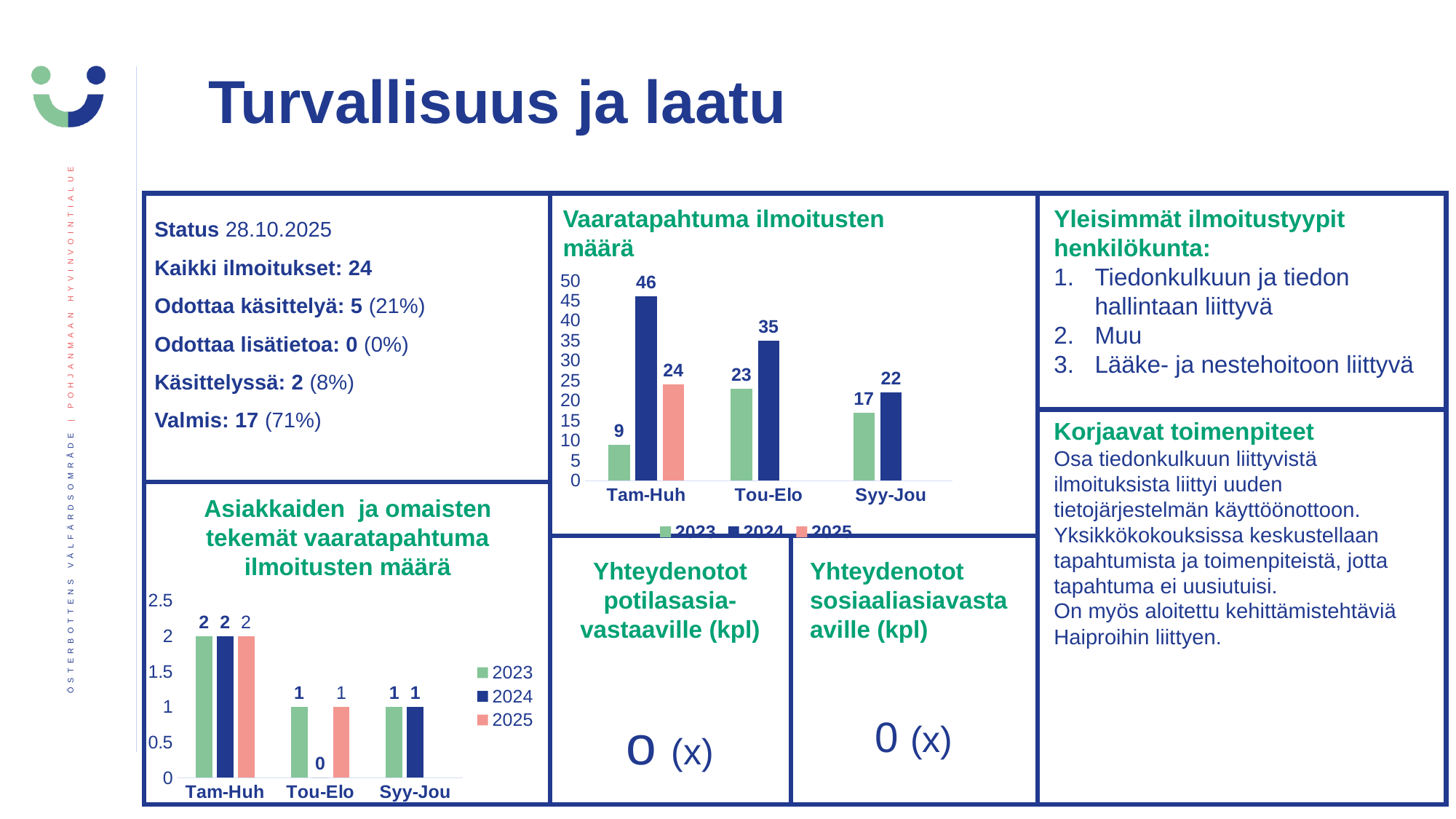
In the 'Vaaratapahtuma ilmoitusten määrä' chart, what is the value for 2024 in Tam-Huh? 46 In the 'Vaaratapahtuma ilmoitusten määrä' chart, which period has the lowest 2023 value? Tam-Huh In the 'Asiakkaiden ja omaisten tekemät vaaratapahtuma ilmoitusten määrä' chart, what is the value for 2025 in Tam-Huh? 2 How many periods are shown on the x axis of the 'Asiakkaiden ja omaisten tekemät vaaratapahtuma ilmoitusten määrä' chart? 3 In the 'Vaaratapahtuma ilmoitusten määrä' chart, which is larger in Tou-Elo: the 2023 value or the 2024 value? 2024 In the 'Vaaratapahtuma ilmoitusten määrä' chart, what is the difference between the 2024 and 2023 values in Syy-Jou? 5 In the 'Vaaratapahtuma ilmoitusten määrä' chart, which period has the highest 2024 value? Tam-Huh How many series does the legend of the 'Vaaratapahtuma ilmoitusten määrä' chart list? 3 In the 'Asiakkaiden ja omaisten tekemät vaaratapahtuma ilmoitusten määrä' chart, what is the value for 2024 in Tou-Elo? 0 In the 'Vaaratapahtuma ilmoitusten määrä' chart, what is the value for 2023 in Tou-Elo? 23 In the 'Vaaratapahtuma ilmoitusten määrä' chart, what is the value for 2025 in Tam-Huh? 24 What kind of chart is the 'Asiakkaiden ja omaisten tekemät vaaratapahtuma ilmoitusten määrä' chart? Bar chart